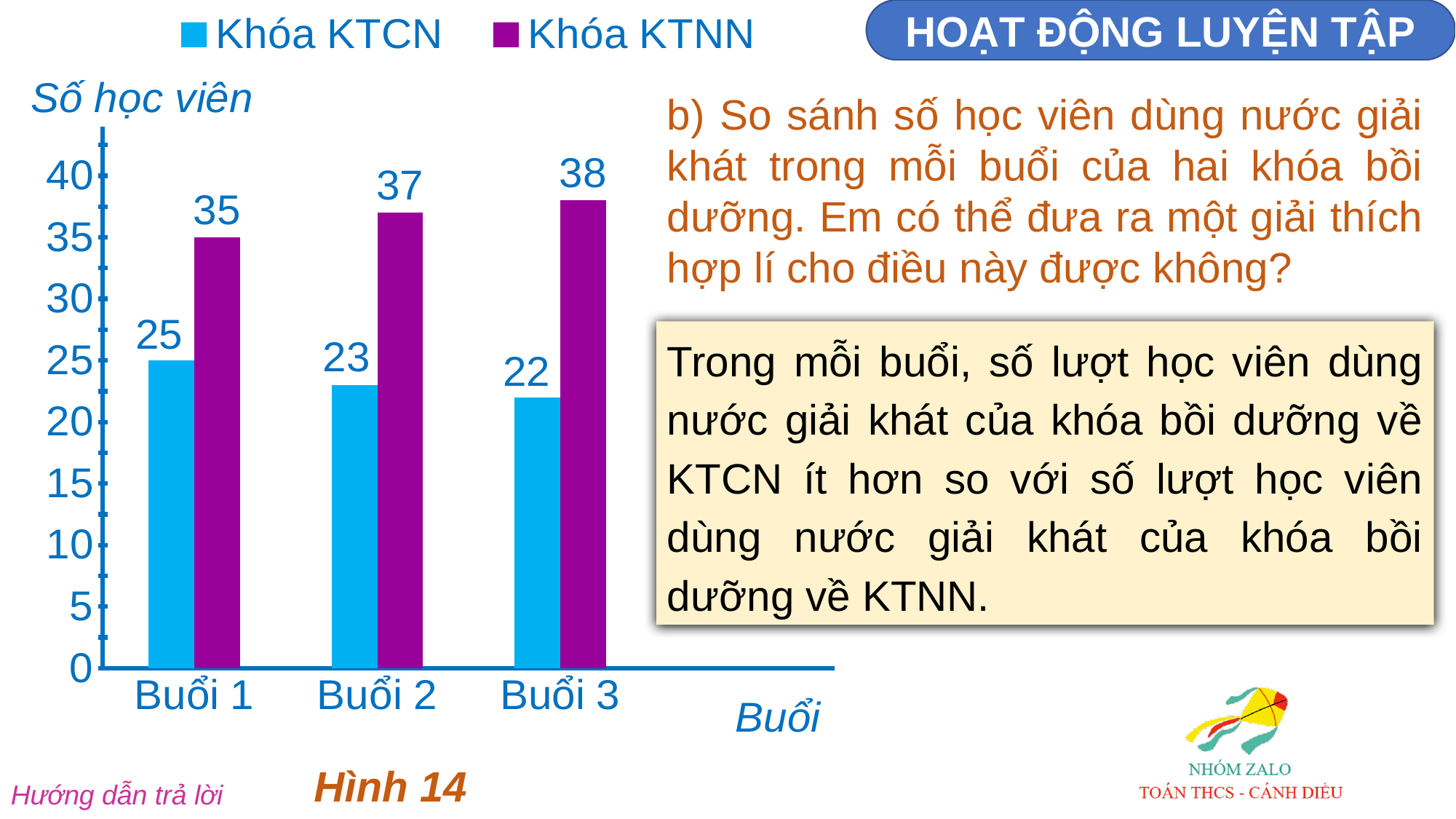
Do the values for Khóa KTCN rise or fall from Buổi 1 to Buổi 3? Fall Which session (Buổi) has the highest value for Khóa KTNN? Buổi 3 What kind of chart is shown on the slide? Bar chart What is the value for Khóa KTNN in Buổi 2? 37 How many sessions (categories) are shown on the x axis? 3 What is the difference between Khóa KTNN and Khóa KTCN in Buổi 3? 16 Which session (Buổi) has the lowest value for Khóa KTCN? Buổi 3 What is the difference between Khóa KTNN and Khóa KTCN in Buổi 1? 10 In Buổi 2, which series has the larger value, Khóa KTCN or Khóa KTNN? Khóa KTNN What is the value for Khóa KTNN in Buổi 3? 38 What is the value for Khóa KTCN in Buổi 1? 25 How many series does the legend list? 2